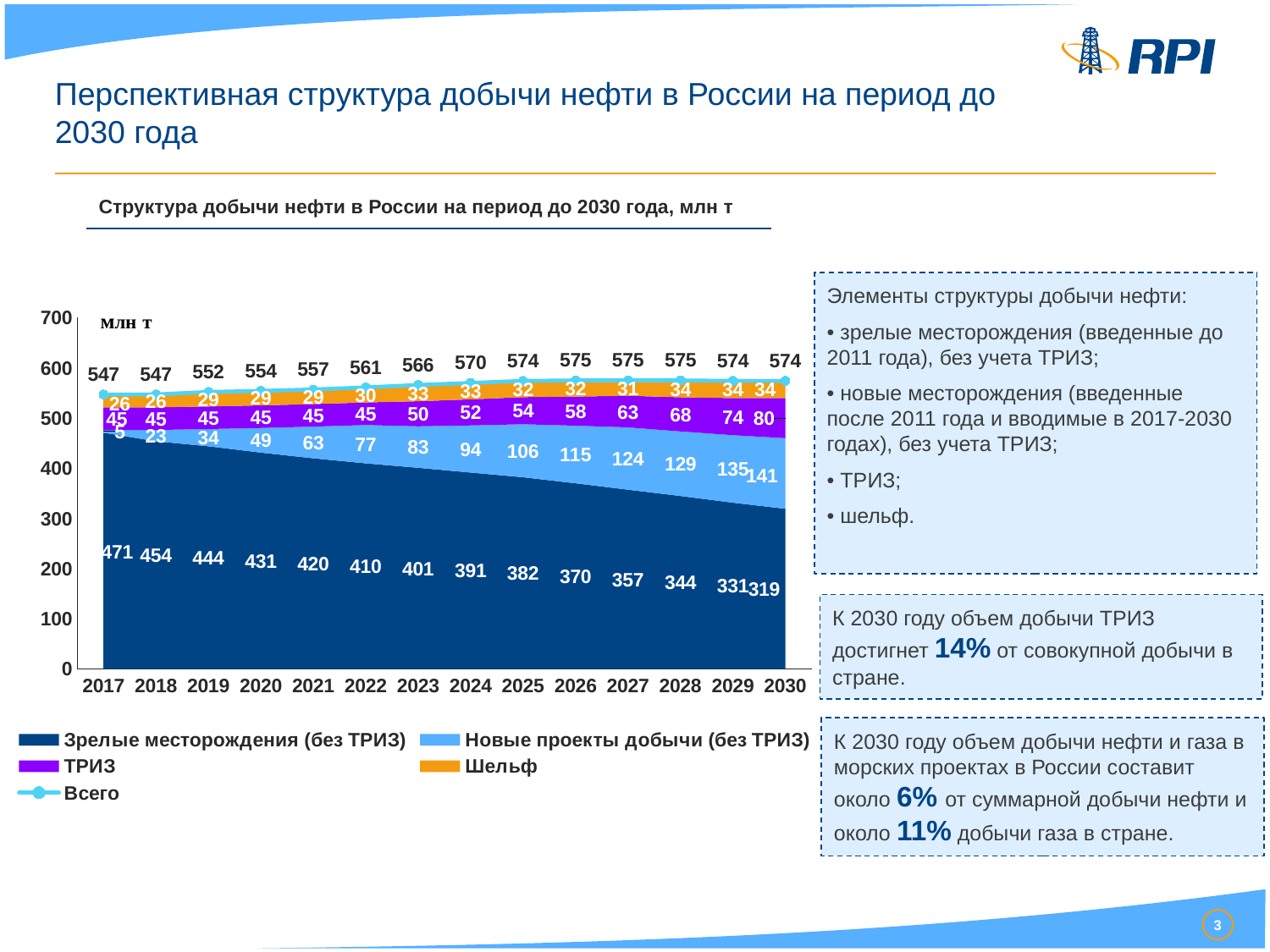
What kind of chart is shown on the slide? stacked area chart with a line for the total In 2030, which is larger: ТРИЗ or Шельф? ТРИЗ How many years are shown on the x axis of the chart? 14 What is the value for Новые проекты добычи (без ТРИЗ) in 2024? 94 Does the value for Новые проекты добычи (без ТРИЗ) rise or fall from 2017 to 2030? rise What is the value of Всего in 2026? 575 In which year is the value for Зрелые месторождения (без ТРИЗ) the highest? 2017 What is the value for ТРИЗ in 2030? 80 What is the value for Зрелые месторождения (без ТРИЗ) in 2017? 471 In which year is the value for Новые проекты добычи (без ТРИЗ) the lowest? 2017 By how much does the value for Зрелые месторождения (без ТРИЗ) decrease from 2017 to 2030? 152 How many series does the chart legend list? 5